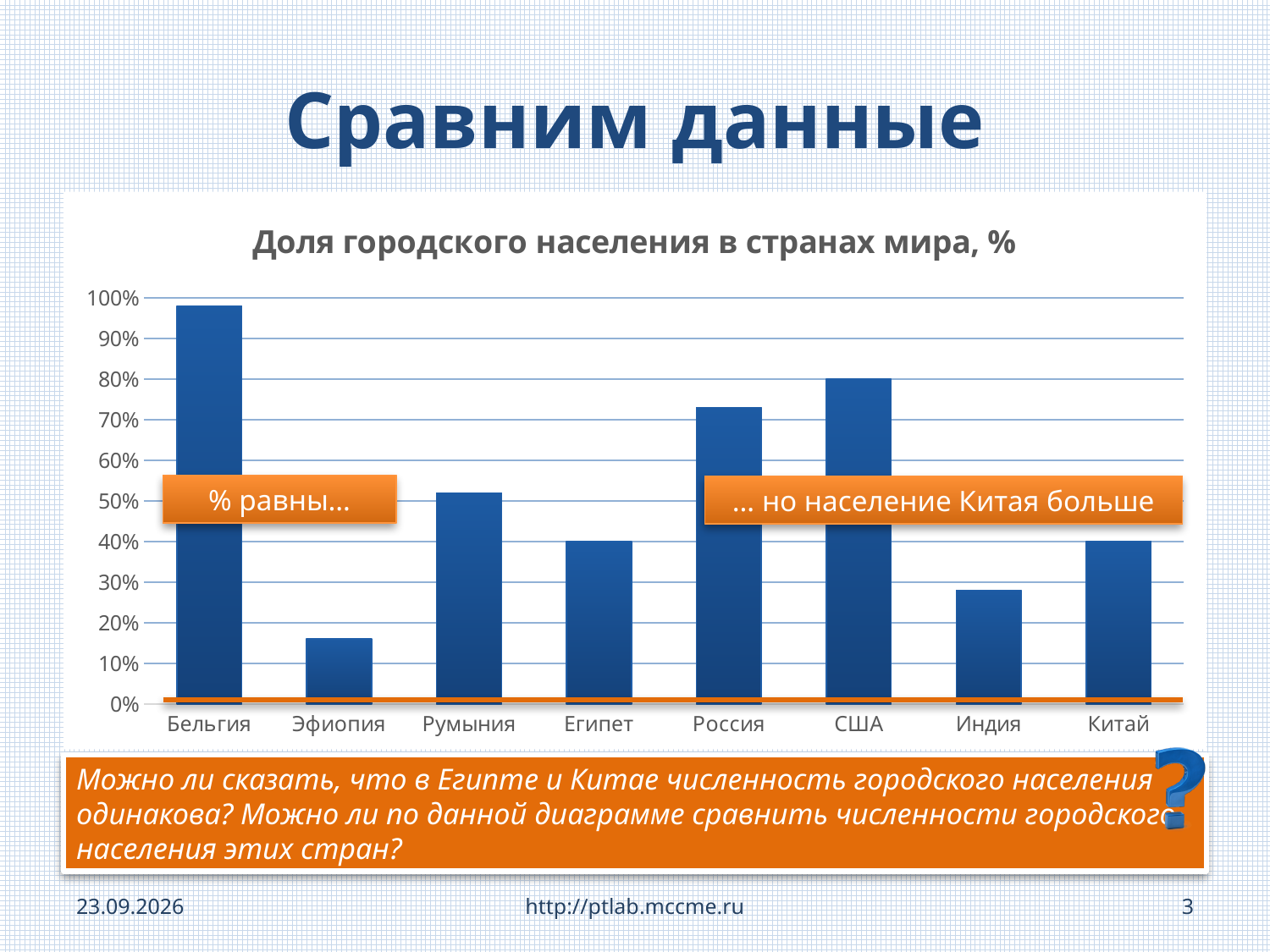
What is the value for Китай? 40% Is the value for Индия greater or less than 30%? less What is the title of the chart? Доля городского населения в странах мира, % Which country has the lowest share of urban population on the chart? Эфиопия What is the value for США? 80% What is the value for Египет? 40% Which has a larger value, Россия or США? США Is the value for Бельгия greater or less than 90%? greater How many countries are shown on the chart? 8 Which country has the highest share of urban population on the chart? Бельгия Is the value for Эфиопия greater or less than 20%? less What type of chart is shown on the slide? bar chart